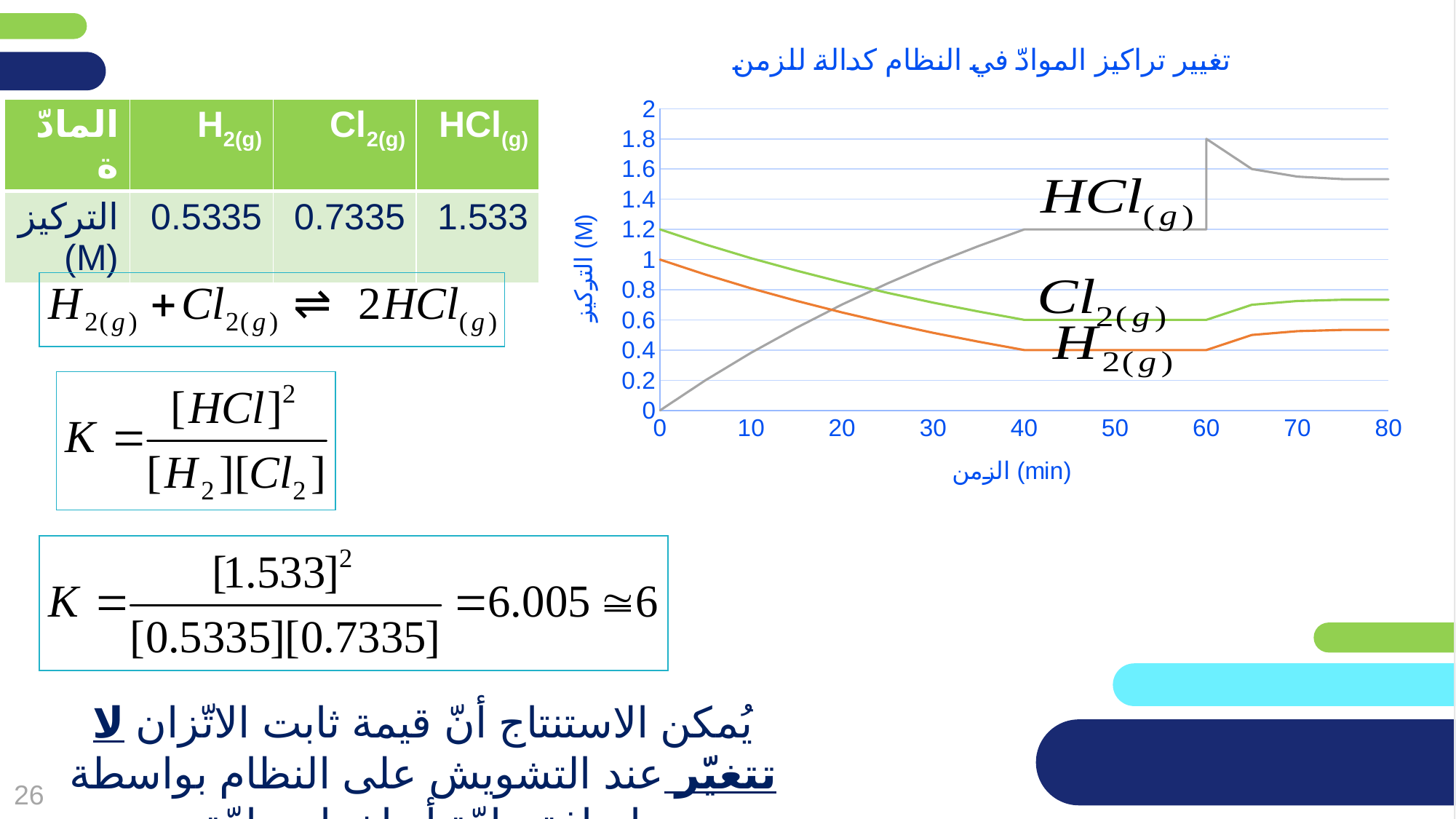
What is the concentration of Cl2(g) at time 0 min? 1.2 What is the concentration of H2(g) at time 0 min? 1 How many substances (lines) are plotted on the chart? 3 What is the concentration of HCl(g) at 50 min? 1.2 Which substance has the lowest concentration at 80 min? H2(g) What kind of chart is shown on the slide? line chart What is the concentration of H2(g) at 50 min? 0.4 Is the concentration of Cl2(g) at 80 min greater or less than 0.6? greater Which substance has the highest concentration at 80 min? HCl(g) What is the peak concentration reached by HCl(g) at 60 min? 1.8 Does the concentration of H2(g) rise or fall between 0 and 40 min? fall What is the concentration of HCl(g) at time 0 min? 0